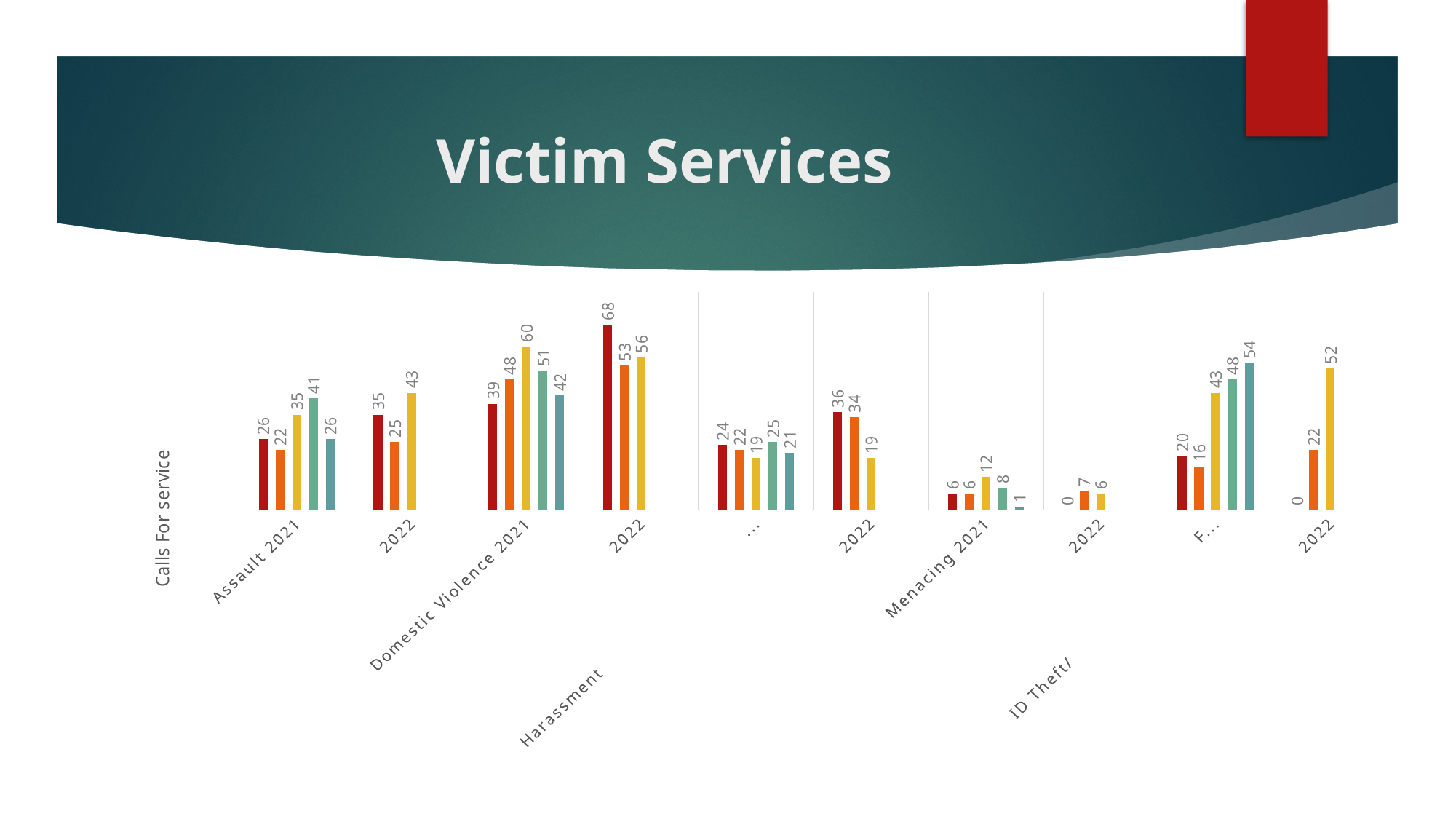
What is the value of the leftmost (dark red) bar in the Assault 2021 group? 26 What is the label on the vertical axis of the chart? Calls For service What is the value of the yellow bar in the 2022 group at the far right of the chart? 52 What is the difference between the tallest bar (41) and the leftmost bar (26) in the Assault 2021 group? 15 What is the total of all five bars in the Menacing 2021 group? 33 How many bars are plotted in the Assault 2021 group? 5 Which is larger: the leftmost (dark red) bar in the Assault 2021 group or the leftmost (dark red) bar in the 2022 group next to it? the 2022 bar (35) What is the value of the shortest bar in the Menacing 2021 group? 1 What is the value of the tallest bar in the Domestic Violence 2021 group? 60 How many bars are plotted in the 2022 group immediately to the right of Domestic Violence 2021? 3 What is the highest data label shown anywhere on the chart, and in which category group does it appear? 68, in the 2022 group next to Domestic Violence 2021 What kind of chart is shown on the slide? bar chart